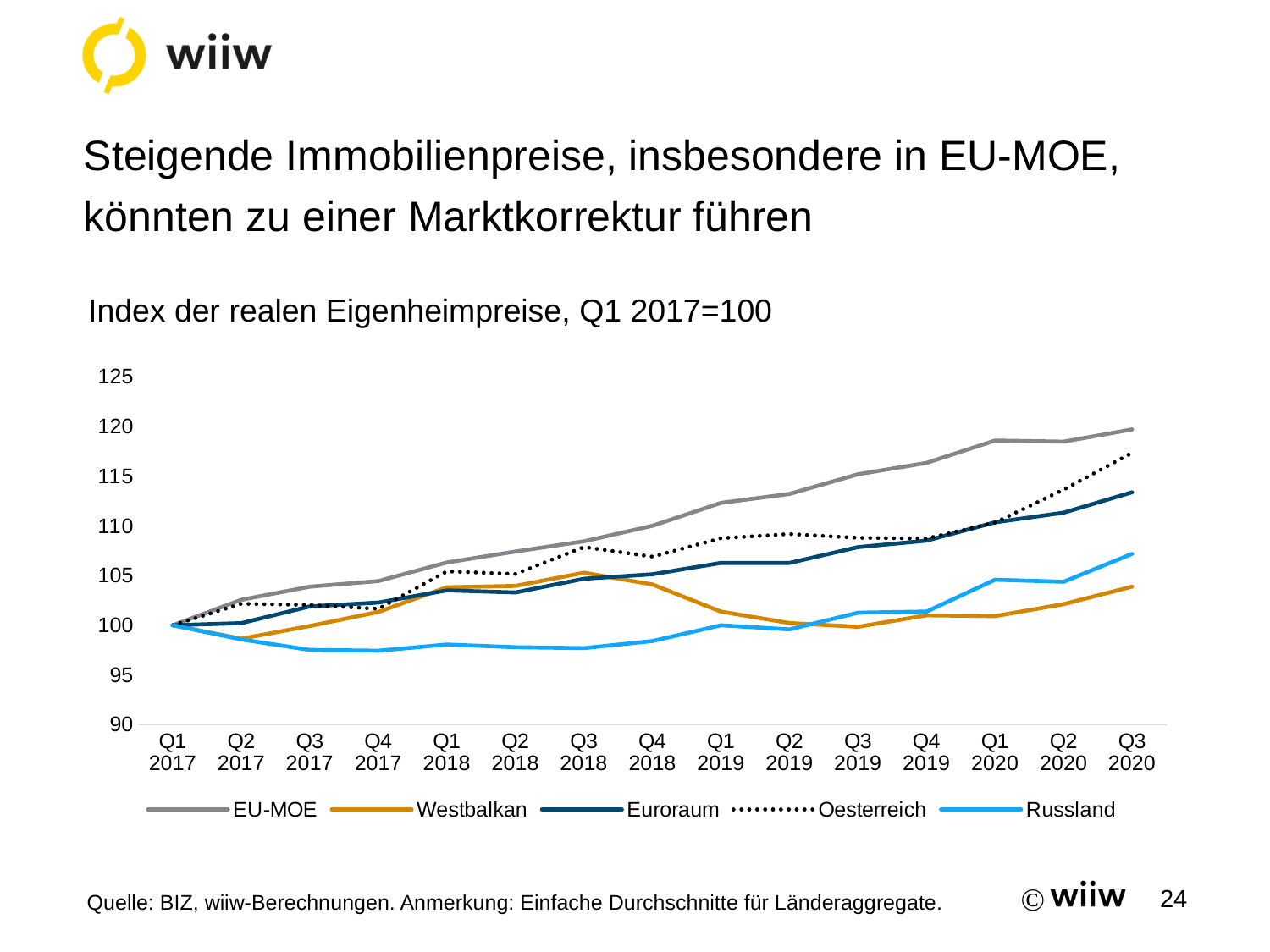
Does the EU-MOE series rise or fall from Q1 2017 to Q3 2020? rise Is the value for Oesterreich in Q3 2020 greater or less than 115? greater Is the value for Russland in Q3 2017 greater or less than 100? less What is the value of every series in Q1 2017? 100 Which series has the lowest value in Q3 2020? Westbalkan How many quarters are plotted along the x axis? 15 What kind of chart is shown on the slide? line chart Which series is drawn with a dotted line? Oesterreich How many series does the legend list? 5 Which series has the highest value in Q3 2020? EU-MOE In Q3 2020, which is larger: the value for Russland or the value for Westbalkan? Russland Is the value for EU-MOE in Q3 2020 greater or less than 115? greater